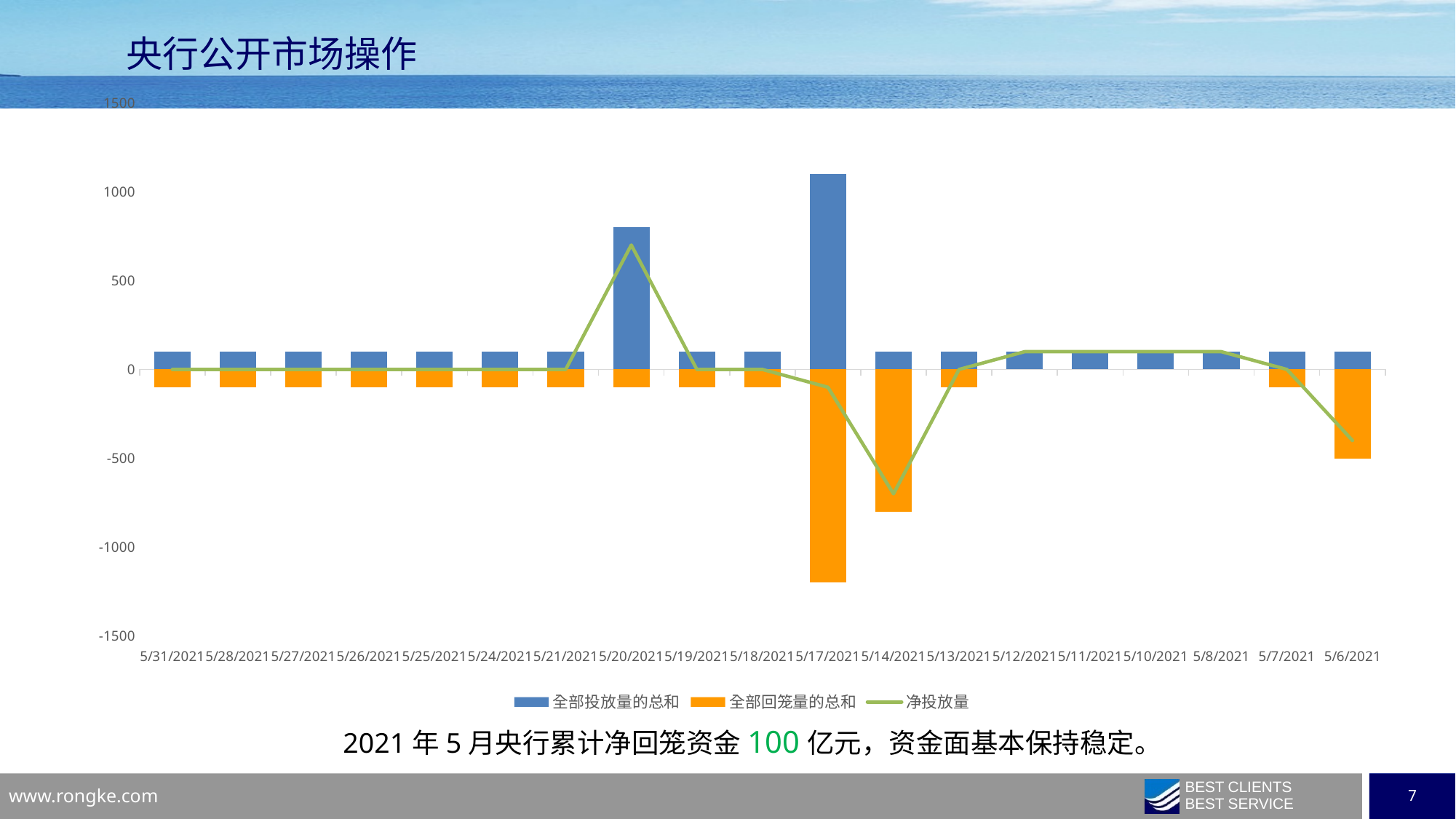
Is the 全部回笼量的总和 value for 5/14/2021 greater or less than -500? less On which date does the 全部回笼量的总和 bar reach its lowest (most negative) value? 5/17/2021 On which date is the 全部投放量的总和 bar the highest? 5/17/2021 What kind of chart is shown on the slide? Combined bar and line chart Which date has the larger 全部投放量的总和 bar, 5/17/2021 or 5/20/2021? 5/17/2021 On which date does the 净投放量 line reach its lowest point? 5/14/2021 On which date does the 净投放量 line reach its highest point? 5/20/2021 How many series does the chart legend list? 3 Is the 全部投放量的总和 value for 5/17/2021 greater or less than 1000? greater What is the title of the chart on the slide? 央行公开市场操作 How many dates are shown on the x axis of the chart? 19 Which series is drawn as a green line in the chart? 净投放量